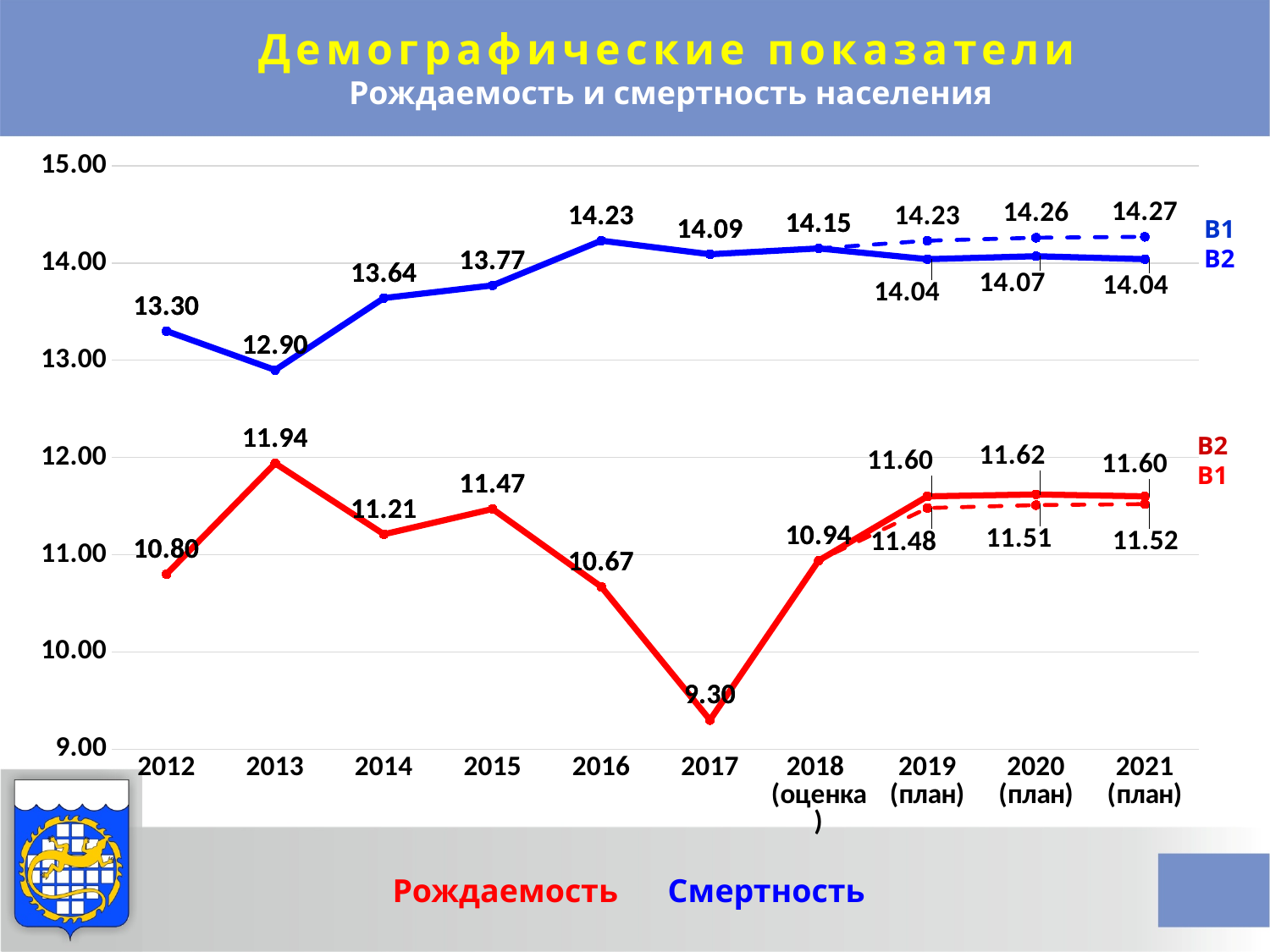
What is the Смертность value for 2018 (оценка)? 14.15 What is the value of Смертность in 2016? 14.23 In which year does Рождаемость reach its lowest value? 2017 What is the value of Рождаемость in 2017? 9.30 How many years are shown on the x axis? 10 What is the difference between Смертность and Рождаемость in 2012? 2.50 What type of chart is shown on the slide? Line chart In which year is Смертность at its lowest? 2013 What is the value of Рождаемость in 2013? 11.94 Does Рождаемость rise or fall from 2015 to 2017? Fall Which is larger in 2015, Смертность or Рождаемость? Смертность What colour is the Рождаемость line? Red